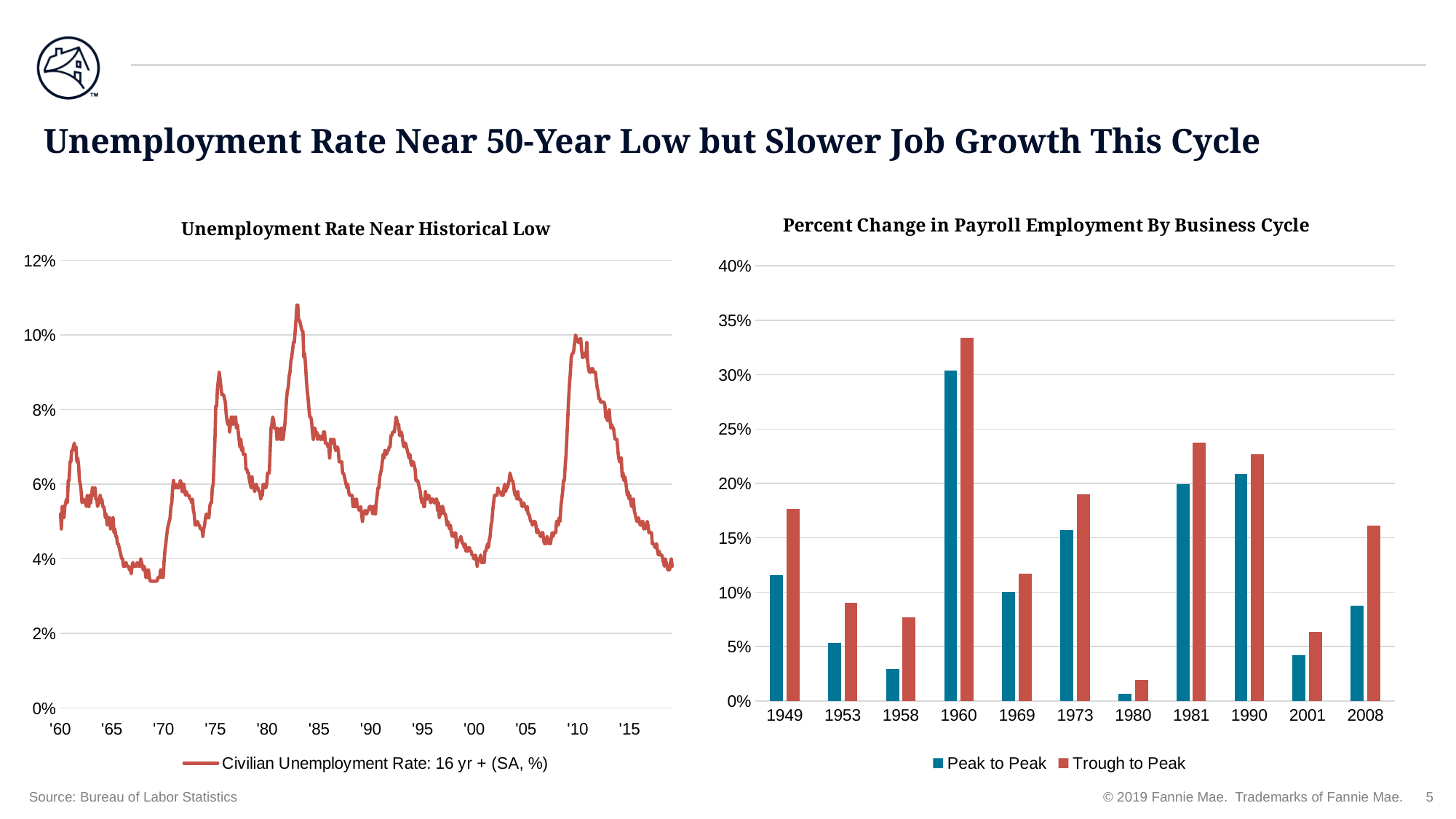
What kind of chart is the 'Unemployment Rate Near Historical Low' chart on the left? line chart In the 'Percent Change in Payroll Employment By Business Cycle' chart, is the Peak to Peak value for 2008 greater or less than 10%? less In the 'Percent Change in Payroll Employment By Business Cycle' chart, which year has the highest Trough to Peak value? 1960 In the 'Percent Change in Payroll Employment By Business Cycle' chart, which is larger: the Trough to Peak value for 1973 or for 1969? 1973 What kind of chart is the 'Percent Change in Payroll Employment By Business Cycle' chart on the right? bar chart In the 'Unemployment Rate Near Historical Low' chart, does the unemployment rate rise or fall between '10 and '15? fall How many series does the legend of the 'Percent Change in Payroll Employment By Business Cycle' chart list? 2 In the 'Percent Change in Payroll Employment By Business Cycle' chart, is the Trough to Peak value for 1960 greater or less than 30%? greater In the 'Unemployment Rate Near Historical Low' chart, is the peak value around '83 greater or less than 10%? greater In the 'Percent Change in Payroll Employment By Business Cycle' chart, which year has the lowest Peak to Peak value? 1980 What is the legend entry for the series in the 'Unemployment Rate Near Historical Low' chart? Civilian Unemployment Rate: 16 yr + (SA, %) In the 'Percent Change in Payroll Employment By Business Cycle' chart, how many business cycle years are shown on the x axis? 11